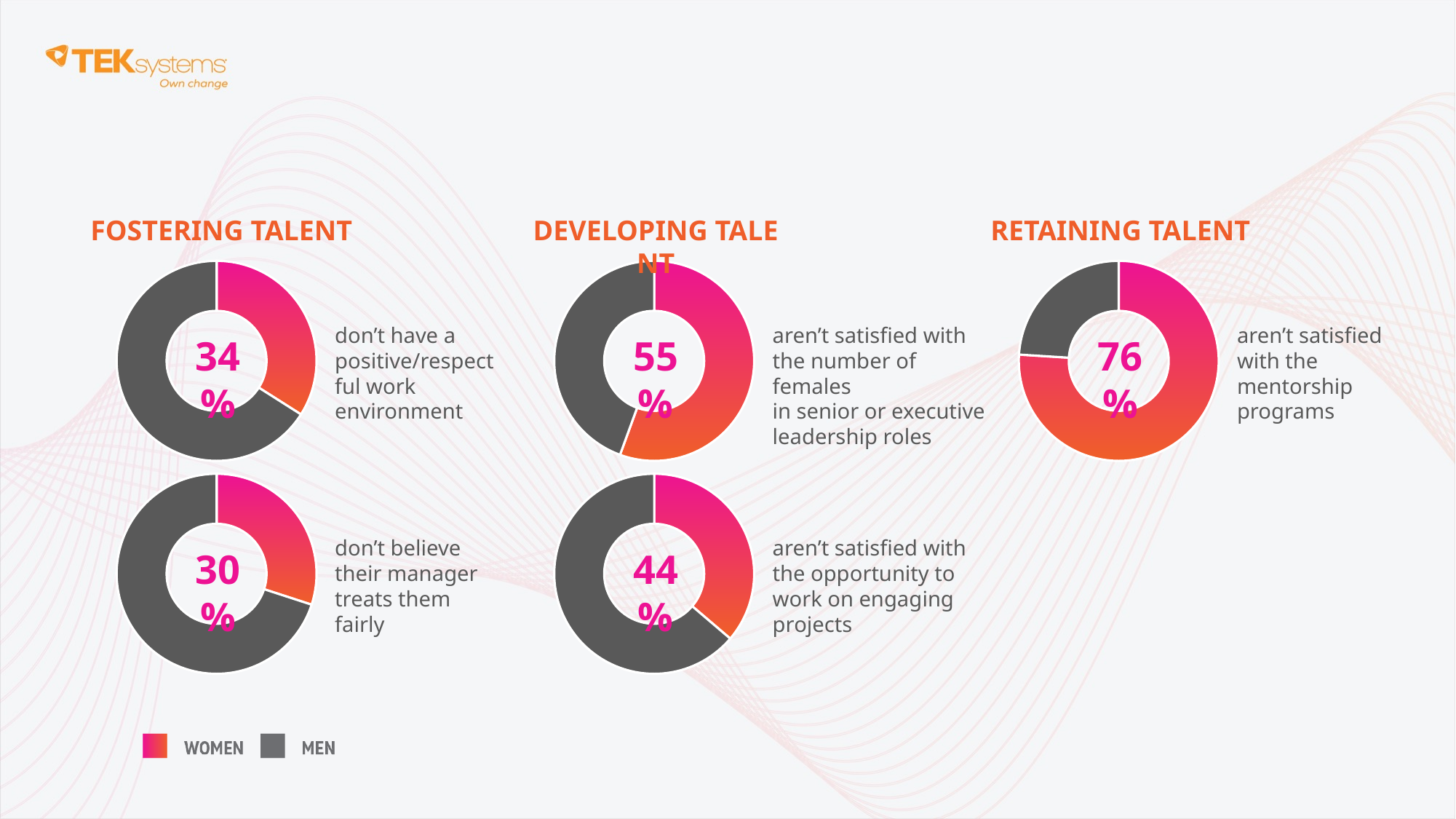
Across all the donut charts on the slide, which chart shows the highest percentage? Retaining Talent (76%) What kind of chart is used to show the percentages on this slide? Donut (pie) chart In the bottom donut chart under Fostering Talent, what percentage is shown in the centre? 30% Which is larger: the percentage in the top Developing Talent chart or the percentage in the bottom Developing Talent chart? The top Developing Talent chart (55%) In the bottom donut chart under Developing Talent, what percentage is shown in the centre? 44% What is the difference between the percentage in the Retaining Talent chart and the percentage in the top Fostering Talent chart? 42% Across all the donut charts on the slide, which chart shows the lowest percentage? Fostering Talent, bottom chart (30%) In the donut chart under Retaining Talent, what percentage is shown in the centre? 76% In the top donut chart under Developing Talent, what percentage is shown in the centre? 55% In the top donut chart under Fostering Talent, what percentage is shown in the centre? 34% How many donut charts are on the slide? 5 How many series does the legend at the bottom of the slide list? 2